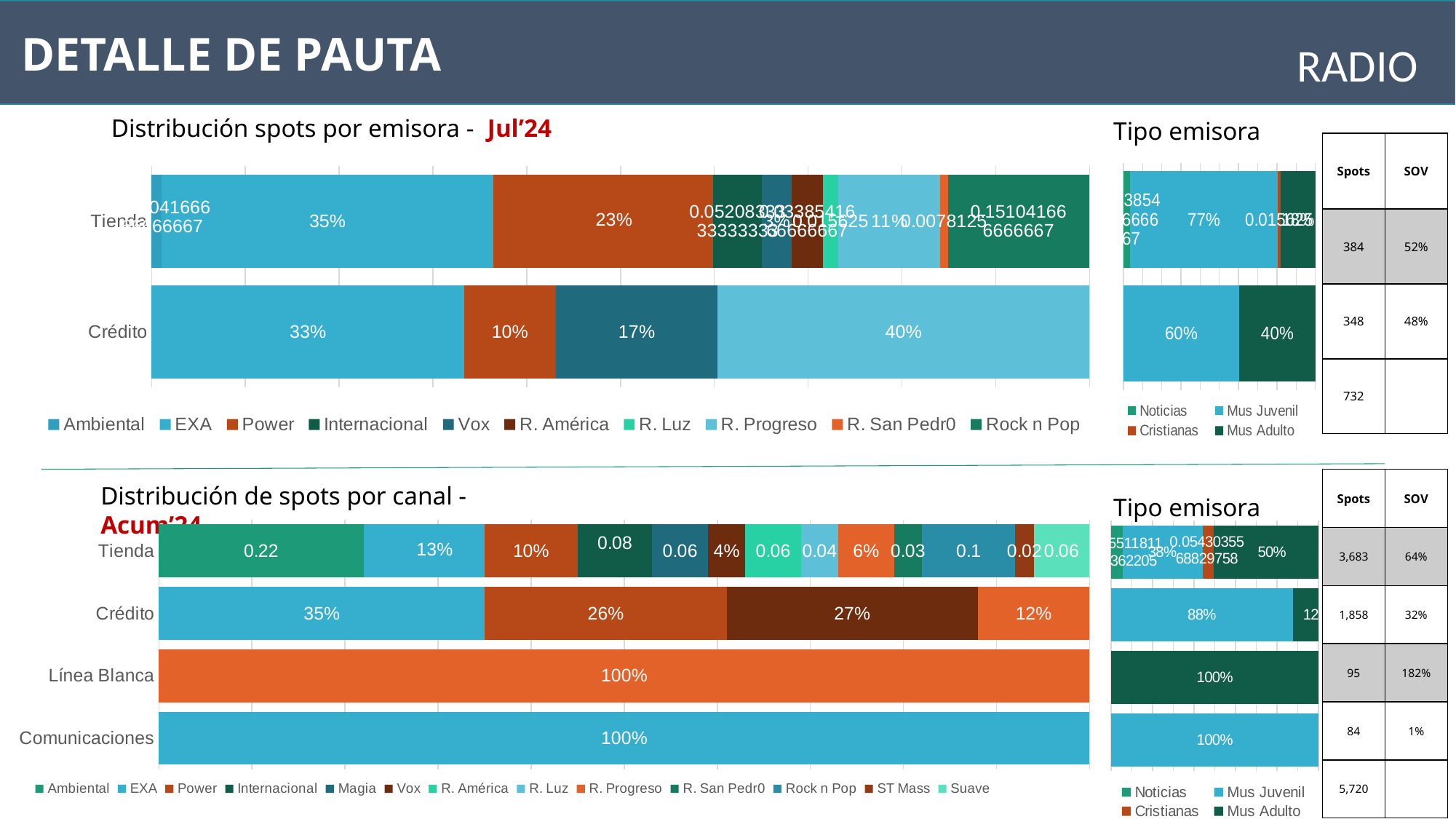
In the 'Distribución de spots por canal - Acum'24' chart, is the Power value for Crédito larger or smaller than the R. Progreso value for Crédito? larger In the 'Distribución spots por emisora - Jul'24' chart, what is the value for R. Progreso in the Crédito bar? 40% In the top-right 'Tipo emisora' chart, what is the Mus Adulto value for Crédito? 40% In the 'Distribución spots por emisora - Jul'24' chart, what is the difference between the EXA and Power values in the Crédito bar? 23% In the 'Distribución de spots por canal - Acum'24' chart, which series makes up 100% of the Línea Blanca bar? R. Progreso How many series does the legend of the 'Distribución spots por emisora - Jul'24' chart list? 10 How many categories (rows) are shown in the 'Distribución de spots por canal - Acum'24' chart? 4 In the 'Distribución spots por emisora - Jul'24' chart, what is the value for Power in the Tienda bar? 23% In the bottom-right 'Tipo emisora' chart, what is the Mus Juvenil value for Crédito? 88% In the 'Distribución spots por emisora - Jul'24' chart, which series has the largest share of the Crédito bar? R. Progreso In the 'Distribución de spots por canal - Acum'24' chart, what is the Vox value for Crédito? 27% In the top-right 'Tipo emisora' chart, what is the Mus Juvenil value for Tienda? 77%